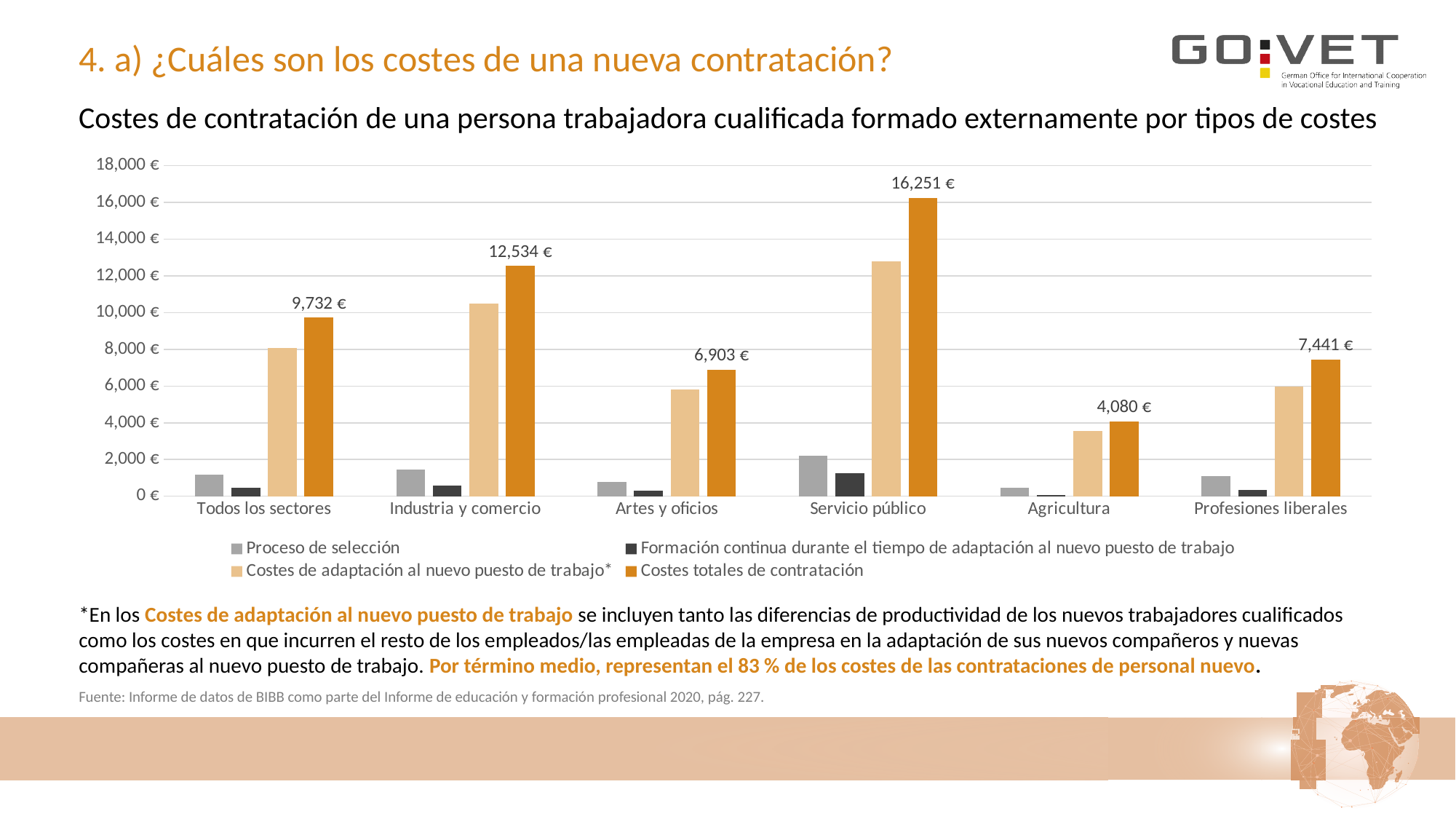
Which category has the highest Costes totales de contratación? Servicio público What is the difference in Costes totales de contratación between Industria y comercio and Todos los sectores? 2,802 € What is the value of Costes totales de contratación for Servicio público? 16,251 € Is the value of Costes de adaptación al nuevo puesto de trabajo for Industria y comercio greater or less than 10,000 €? greater How many categories are shown on the x axis? 6 What kind of chart is shown on the slide? Bar chart What is the value of Costes totales de contratación for Todos los sectores? 9,732 € Which has higher Costes totales de contratación, Industria y comercio or Profesiones liberales? Industria y comercio Which category has the lowest Costes totales de contratación? Agricultura What is the difference in Costes totales de contratación between Servicio público and Agricultura? 12,171 € What is the value of Costes totales de contratación for Agricultura? 4,080 € How many series does the legend list? 4